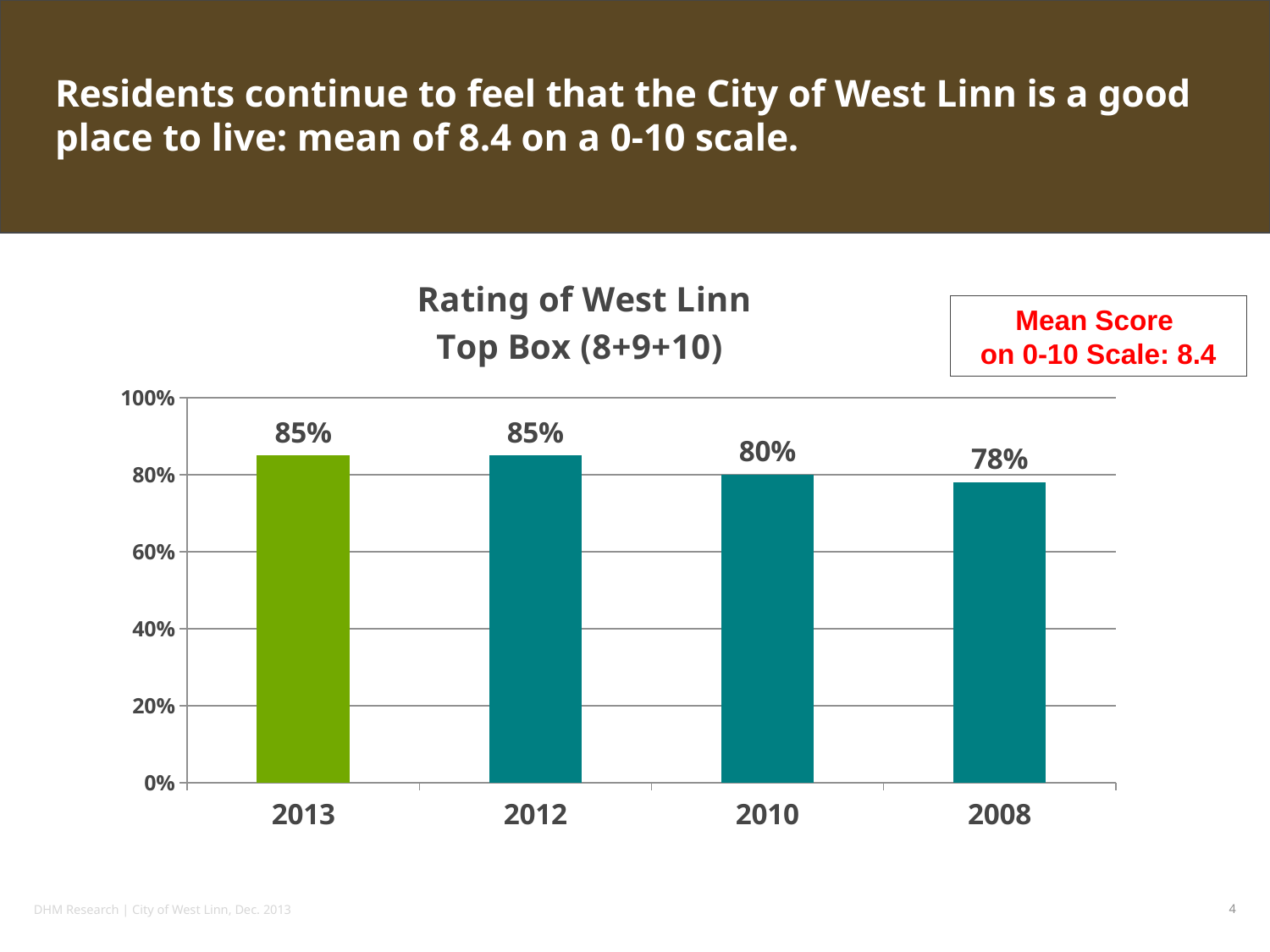
What is the difference between the values for 2013 and 2008? 7% How many years are shown on the x axis? 4 What is the difference between the values for 2012 and 2010? 5% Is the value for 2008 greater or less than 80%? less What mean score on the 0-10 scale is shown in the red box? 8.4 What is the value for 2008? 78% Which is larger, the value for 2010 or the value for 2008? 2010 What is the value for 2010? 80% Which year has the lowest value? 2008 What is the title of the chart? Rating of West Linn Top Box (8+9+10) What is the value for 2013? 85% What kind of chart is shown? bar chart